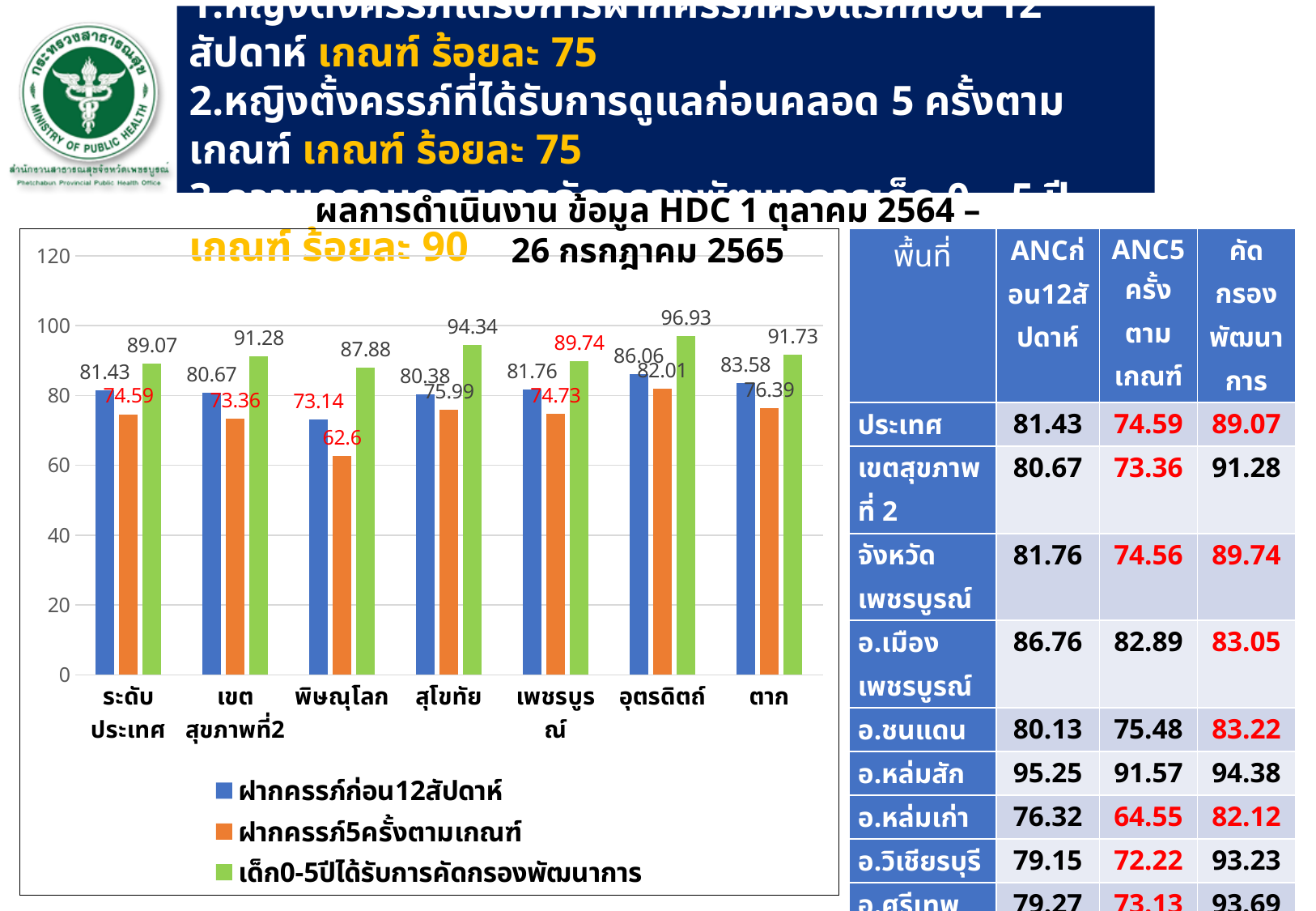
What is the value of ฝากครรภ์5ครั้งตามเกณฑ์ for ตาก? 76.39 What is the value of เด็ก0-5ปีได้รับการคัดกรองพัฒนาการ for อุตรดิตถ์? 96.93 What is the value of ฝากครรภ์ก่อน12สัปดาห์ for พิษณุโลก? 73.14 Which colour represents the series เด็ก0-5ปีได้รับการคัดกรองพัฒนาการ in the chart? green Is the ฝากครรภ์5ครั้งตามเกณฑ์ value for อุตรดิตถ์ greater or less than 80? greater Which is larger: the ฝากครรภ์ก่อน12สัปดาห์ value for สุโขทัย or for ตาก? ตาก What is the difference between the เด็ก0-5ปีได้รับการคัดกรองพัฒนาการ value and the ฝากครรภ์5ครั้งตามเกณฑ์ value for พิษณุโลก? 25.28 How many series does the chart legend list? 3 How many categories are shown on the x axis of the chart? 7 Which category has the highest value for ฝากครรภ์ก่อน12สัปดาห์? อุตรดิตถ์ Which category has the lowest value for ฝากครรภ์5ครั้งตามเกณฑ์? พิษณุโลก What type of chart is shown on the slide? bar chart